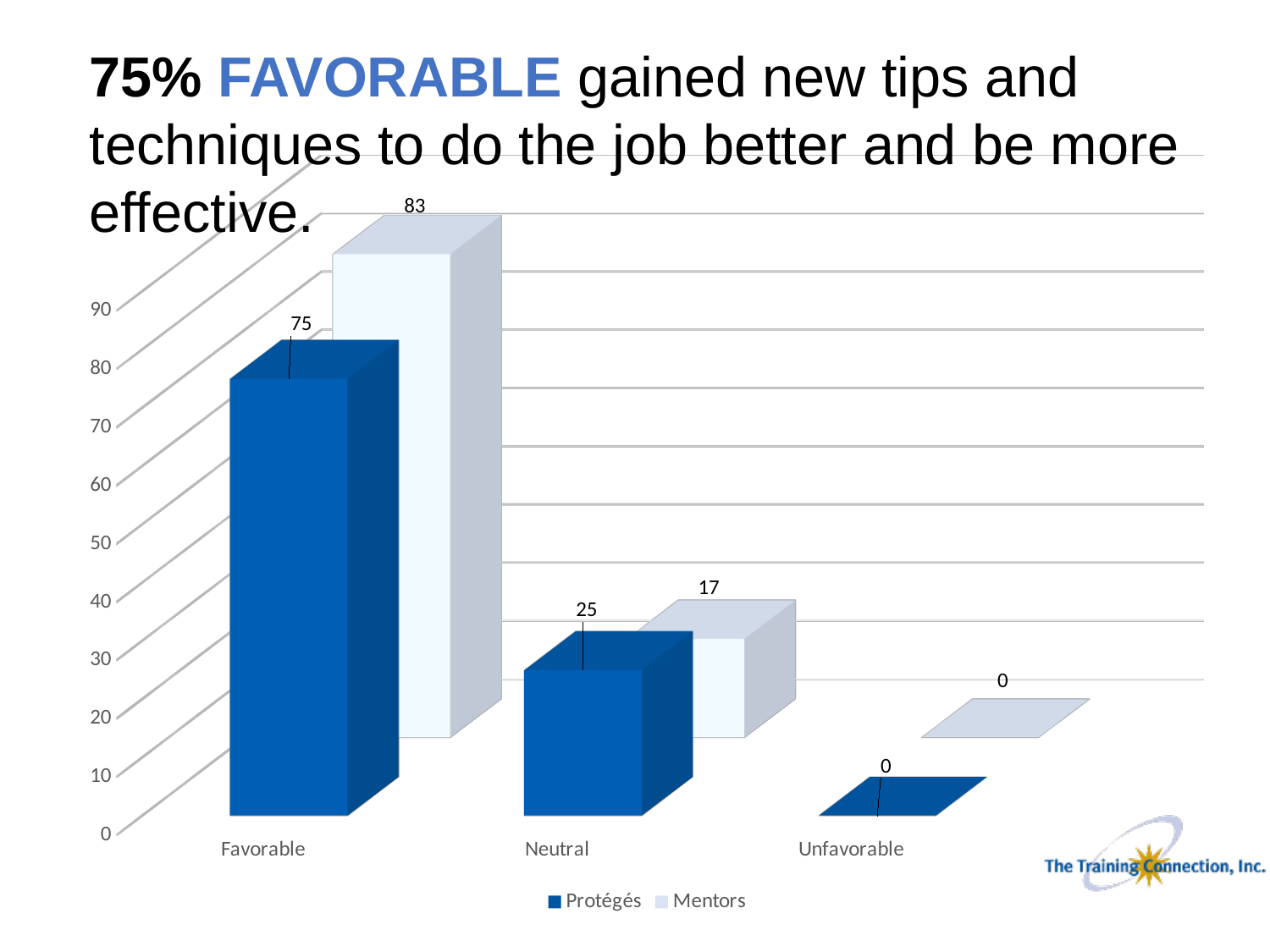
In the Neutral category, which series has the larger value, Protégés or Mentors? Protégés Which category has the lowest value for Protégés? Unfavorable What is the difference between the Mentors and Protégés values in the Favorable category? 8 How many series does the legend list? 2 What is the value for Mentors in the Favorable category? 83 What kind of chart is shown on the slide? Bar chart What is the value for Mentors in the Unfavorable category? 0 How many categories are shown on the x axis? 3 What is the value for Mentors in the Neutral category? 17 Which category has the highest value for Mentors? Favorable What is the value for Protégés in the Favorable category? 75 What is the value for Protégés in the Neutral category? 25